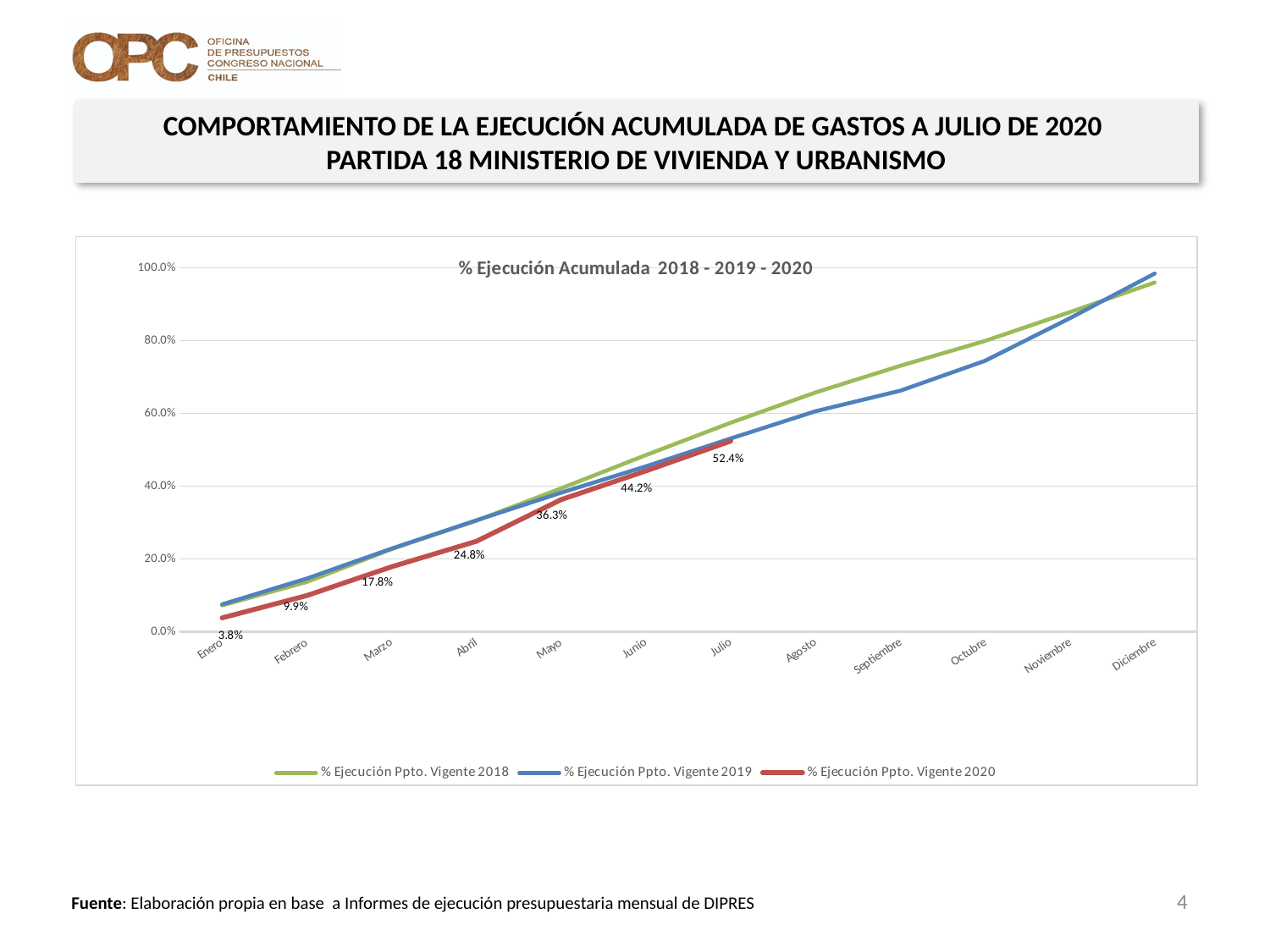
How many months are shown on the x axis? 12 What is the difference between the 2020 values for Junio and Mayo? 7.9 percentage points What is the value of % Ejecución Ppto. Vigente 2020 for Julio? 52.4% What is the title of the chart? % Ejecución Acumulada 2018 - 2019 - 2020 Is the value for % Ejecución Ppto. Vigente 2019 in Diciembre greater or less than 80.0%? greater By how many percentage points did % Ejecución Ppto. Vigente 2020 increase from Enero to Julio? 48.6 percentage points What kind of chart is shown on the slide? Line chart Which month has the highest labelled value for % Ejecución Ppto. Vigente 2020? Julio What is the value of % Ejecución Ppto. Vigente 2020 for Enero? 3.8% How many series does the legend list? 3 Do the values of % Ejecución Ppto. Vigente 2020 rise or fall from Enero to Julio? Rise What is the value of % Ejecución Ppto. Vigente 2020 for Mayo? 36.3%